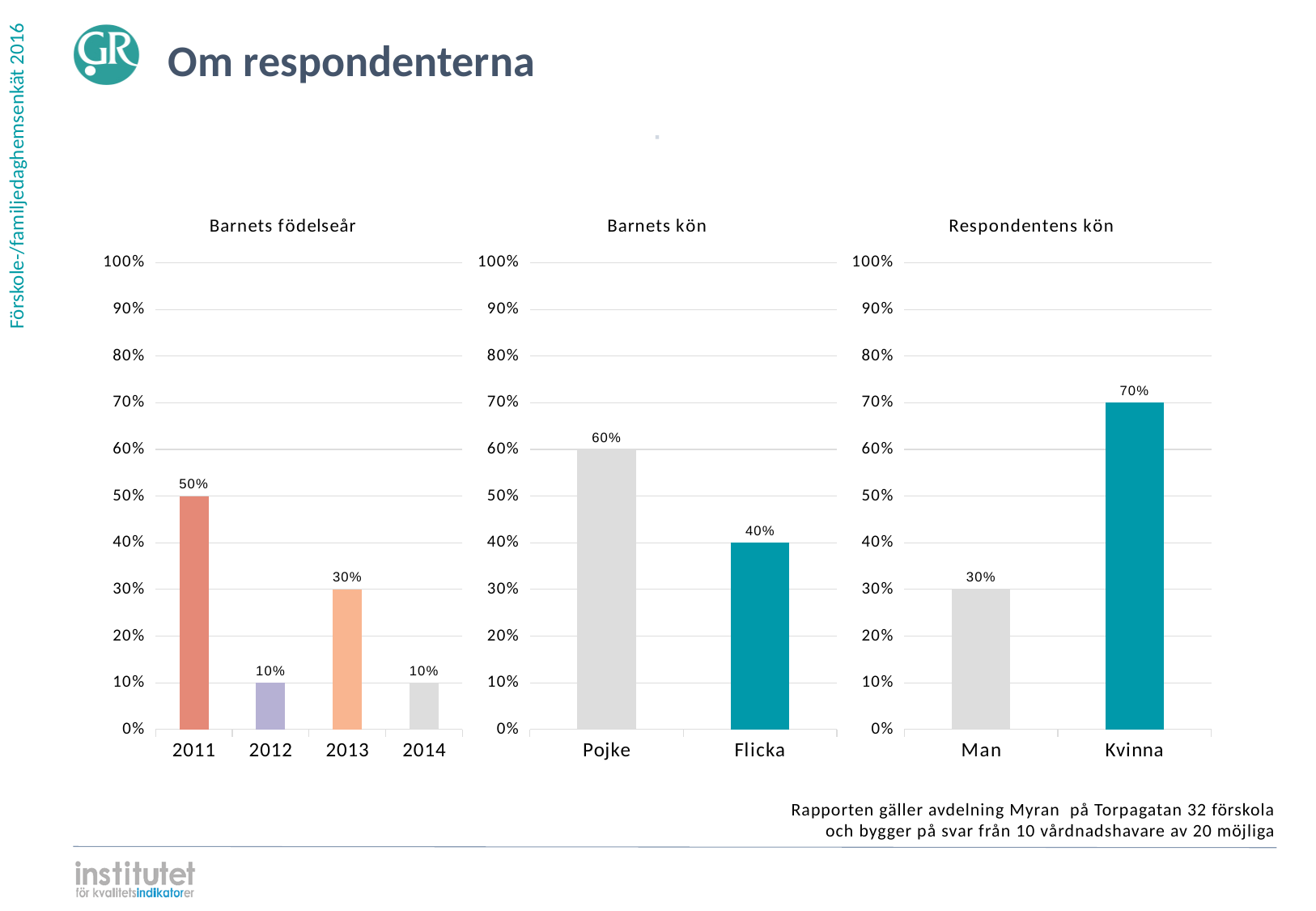
In the 'Barnets kön' chart, what is the difference between Pojke and Flicka? 20% In the 'Barnets födelseår' chart, what is the difference between the values for 2011 and 2013? 20% In the 'Respondentens kön' chart, what is the difference between Kvinna and Man? 40% In the 'Barnets födelseår' chart, what is the value for 2011? 50% In the 'Respondentens kön' chart, what is the value for Kvinna? 70% In the 'Barnets kön' chart, what is the value for Pojke? 60% In the 'Barnets födelseår' chart, which birth year has the highest value? 2011 In the 'Barnets födelseår' chart, what is the value for 2013? 30% In the 'Respondentens kön' chart, which category has the lowest value? Man In the 'Barnets födelseår' chart, how many birth years are shown? 4 In the 'Barnets kön' chart, which is larger, Pojke or Flicka? Pojke What kind of chart is the 'Respondentens kön' chart? Bar chart